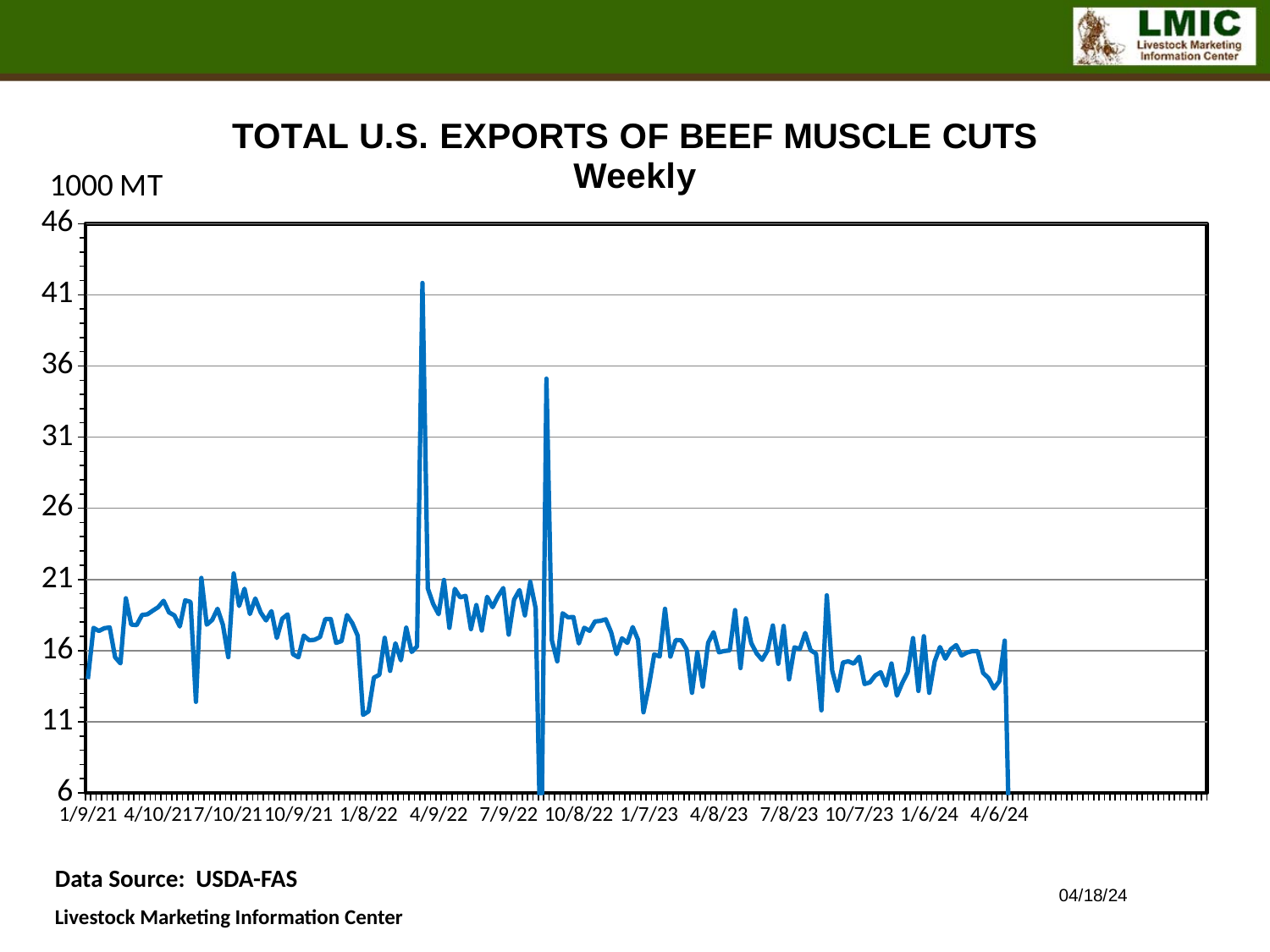
Near which x-axis date label does the highest spike in the line occur? 4/9/22 How many lines (series) are plotted on the chart? 1 How many date labels are shown along the x axis? 14 Is the first plotted value, at 1/9/21, greater or less than 16? less Is the value at the highest spike (near 4/9/22) greater or less than 36? greater What are the lowest and highest values shown on the y axis? 6 and 46 What is the title of the chart? TOTAL U.S. EXPORTS OF BEEF MUSCLE CUTS Weekly What kind of chart is shown on the slide? line chart Which spike is larger: the one near 4/9/22 or the one just before 10/8/22? the one near 4/9/22 What unit is shown on the y axis of the chart? 1000 MT Is the value at the second large spike (just before 10/8/22) greater or less than 31? greater